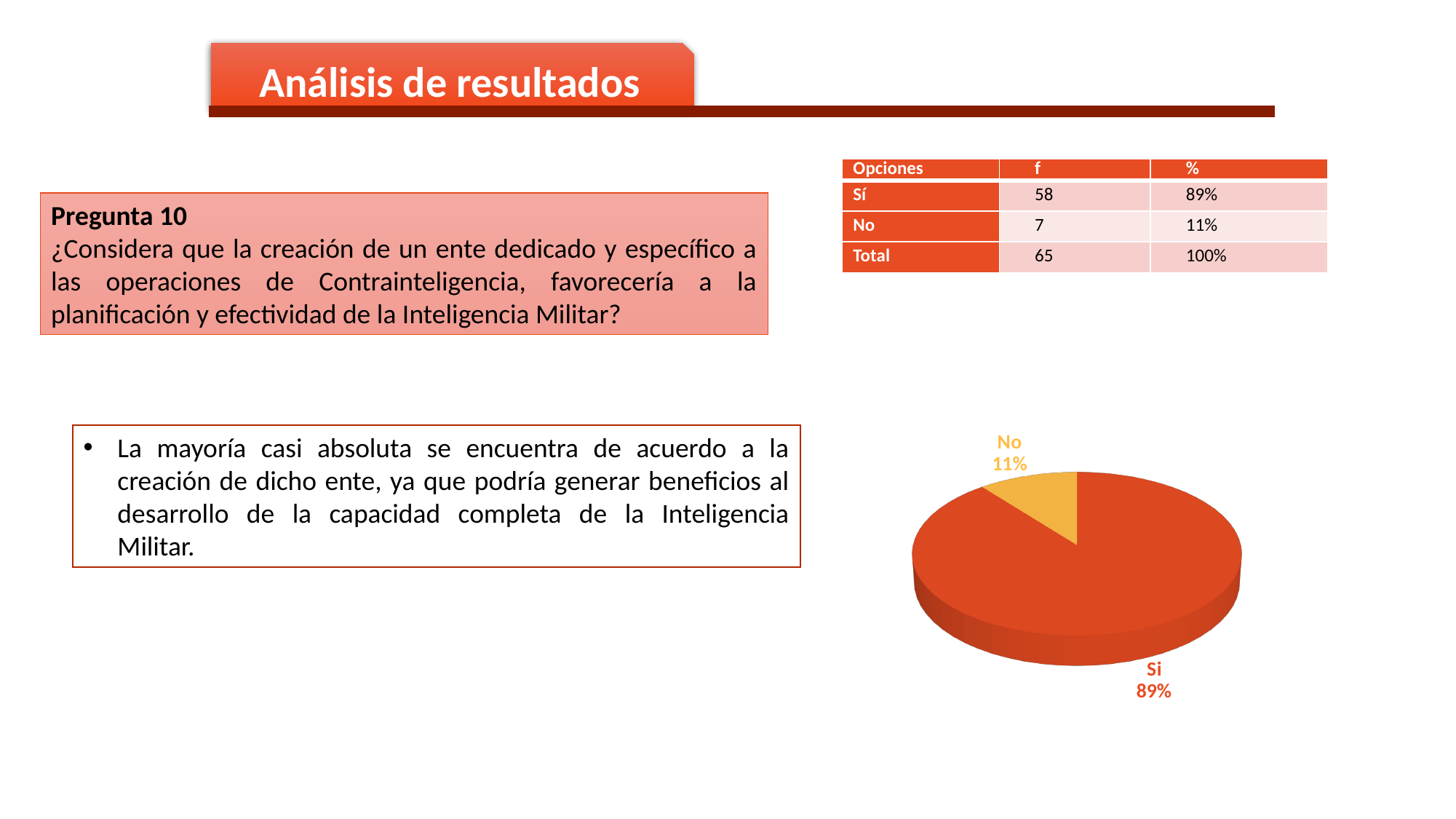
What is the difference in percentage points between the Si and No slices of the pie chart? 78 What colour is the No slice in the pie chart? yellow-orange Which slice is larger in the pie chart, Si or No? Si What share of the pie does the Si slice represent? 89% What percentage does the pie chart show for No? 11% Which slice of the pie chart is the smallest? No Which slice of the pie chart is the largest? Si What kind of chart is shown on the slide? pie chart What colour is the Si slice in the pie chart? red-orange How many slices does the pie chart have? 2 What percentage does the pie chart show for Si? 89%